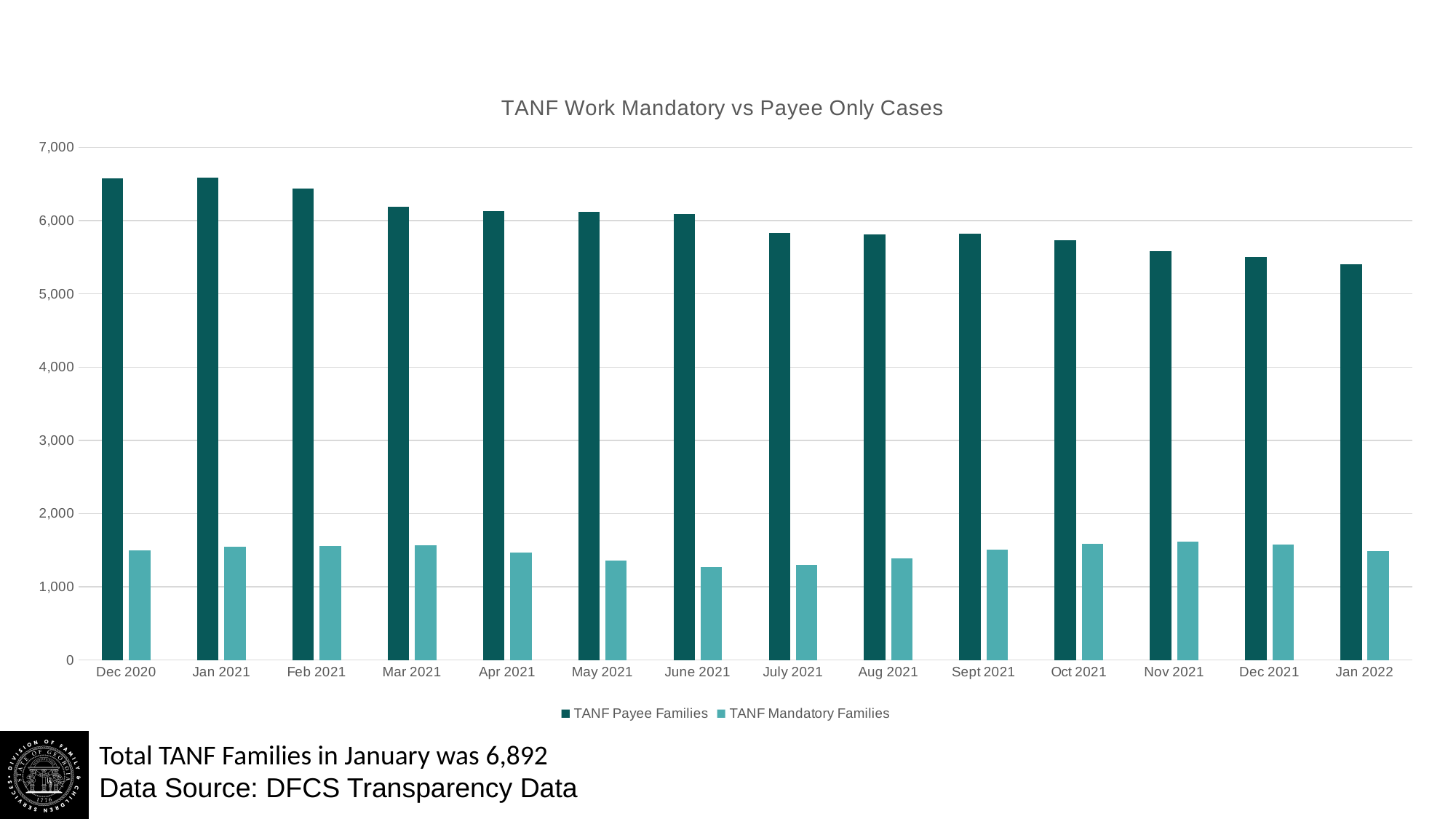
Is the value for TANF Payee Families in Jan 2022 greater or less than 6,000? less What kind of chart is shown on the slide? Bar chart Is the value for TANF Payee Families in Dec 2020 greater or less than 6,000? greater Is the value for TANF Mandatory Families in Nov 2021 greater or less than 1,000? greater How many months are shown on the x axis? 14 How many series does the legend list? 2 Which month has the lowest value for TANF Payee Families? Jan 2022 Do the values for TANF Payee Families generally rise or fall from Dec 2020 to Jan 2022? fall What is the title of the chart? TANF Work Mandatory vs Payee Only Cases Which is larger in Jan 2022, TANF Payee Families or TANF Mandatory Families? TANF Payee Families Which series is shown in the darker teal colour? TANF Payee Families